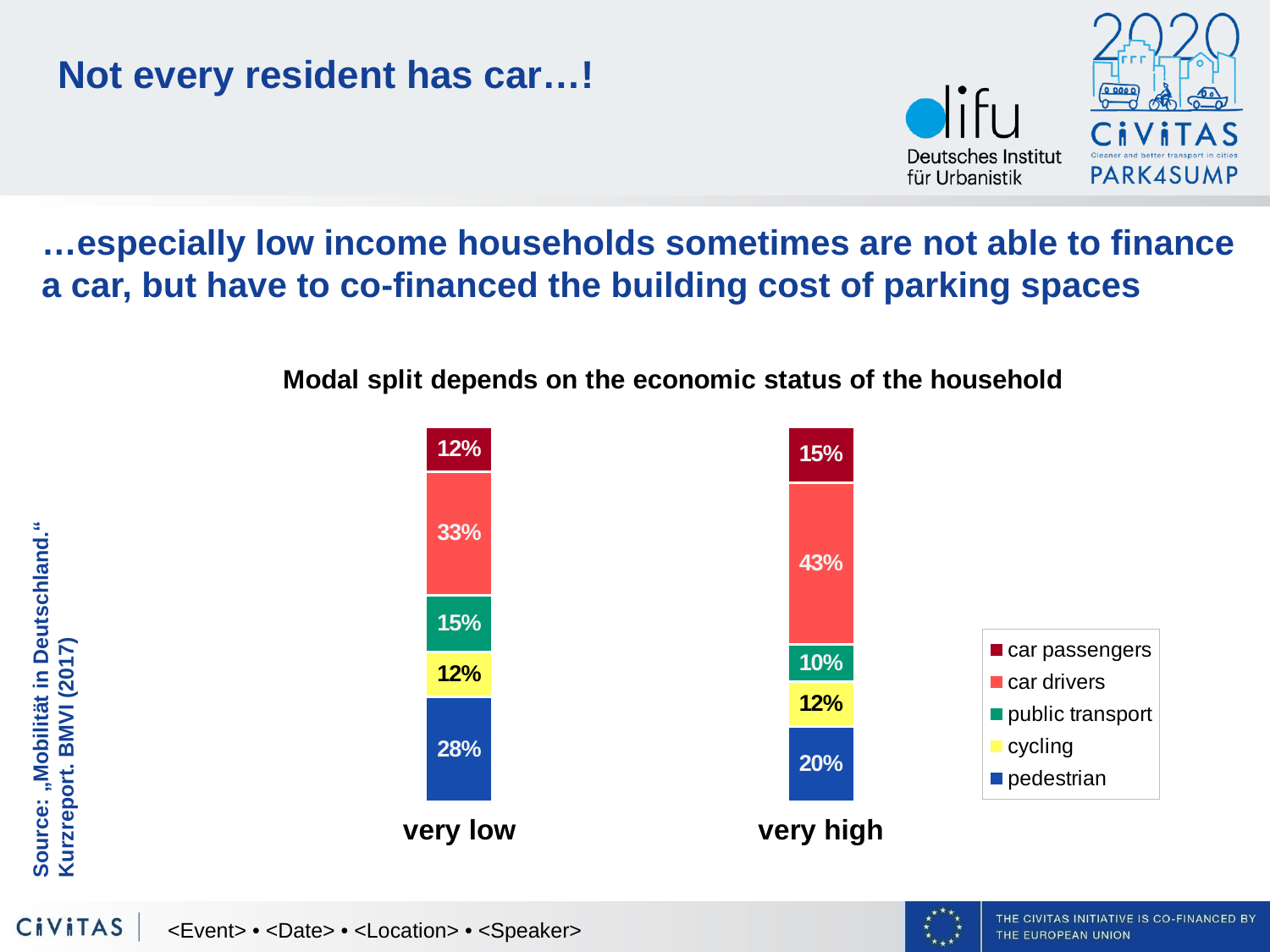
What is the car passengers share for the 'very high' group? 15% Which mode has the largest share in the 'very high' group? car drivers How many series does the legend list? 5 What type of chart is shown on the slide? stacked bar chart What share of trips is made by car drivers in the 'very low' economic status group? 33% What is the pedestrian share for the 'very low' group? 28% What is the public transport share for the 'very high' group? 10% Which mode has the smallest share in the 'very high' group? public transport Which group has the larger pedestrian share, 'very low' or 'very high'? very low What is the difference between the car drivers share in the 'very high' group and in the 'very low' group? 10% What share of trips is made by car drivers in the 'very high' economic status group? 43% How many categories are shown on the x axis? 2